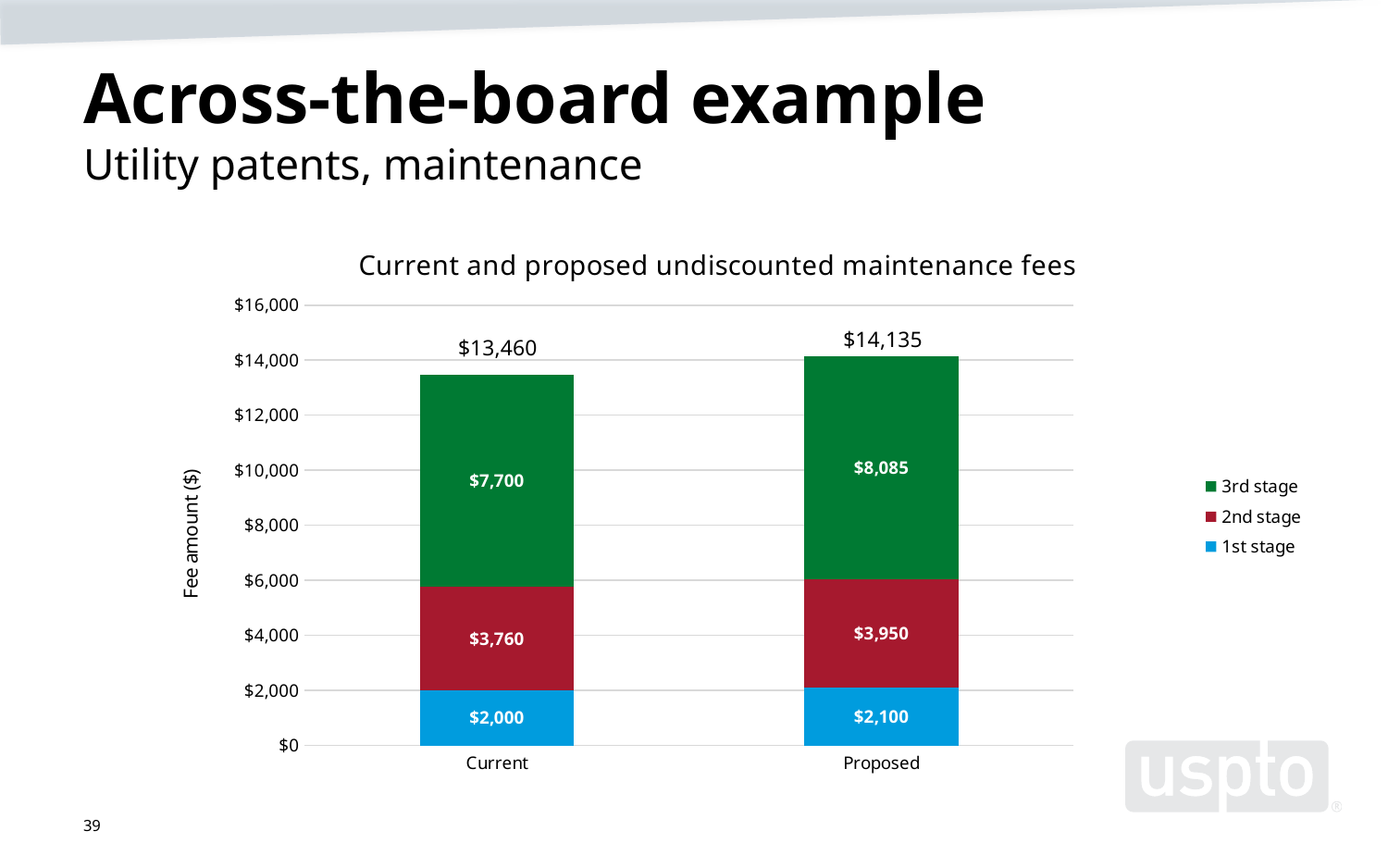
What is the total of the Current stacked bar? $13,460 What is the total of the Proposed stacked bar? $14,135 What kind of chart is shown on the slide? Stacked bar chart What is the difference between the Proposed and Current total maintenance fees? $675 What is the 1st stage fee for the Current category? $2,000 What is the difference between the Proposed and Current 3rd stage fees? $385 Which stage has the lowest fee in the Proposed bar? 1st stage How many categories are shown on the x axis? 2 Which category has the higher total maintenance fee, Current or Proposed? Proposed What is the 3rd stage fee for the Current category? $7,700 What is the 2nd stage fee for the Proposed category? $3,950 How many series does the legend list? 3